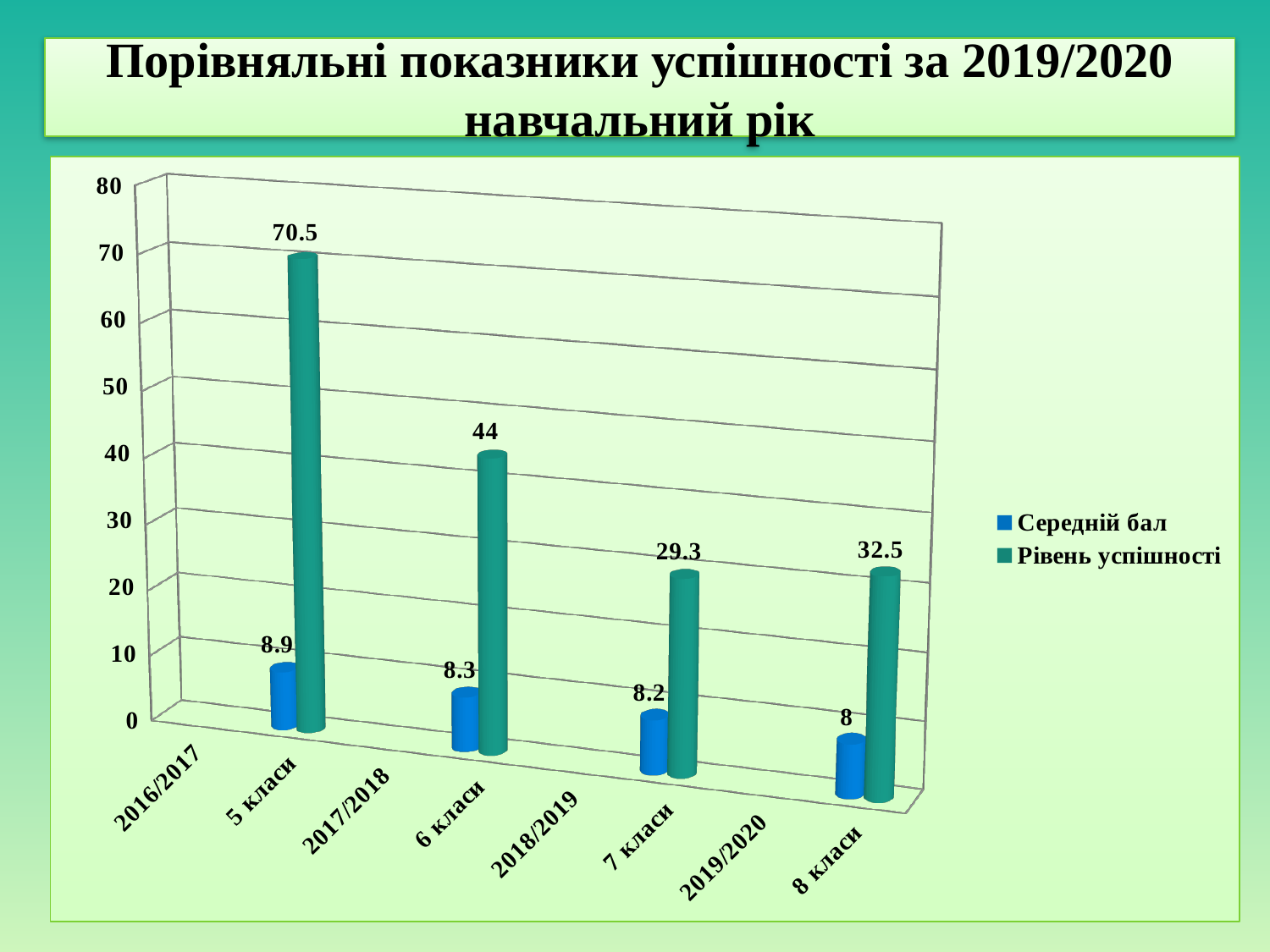
Which category has the highest Рівень успішності? 5 класи How many series does the legend list? 2 Which category has the lowest Середній бал? 8 класи What is the value of Середній бал for 6 класи? 8.3 Which colour represents Середній бал in the legend? Blue What is the value of Рівень успішності for 8 класи? 32.5 Which is larger: Рівень успішності for 7 класи or for 8 класи? 8 класи What is the difference between Рівень успішності for 5 класи and 6 класи? 26.5 What is the value of Середній бал for 7 класи? 8.2 What is the value of Рівень успішності for 5 класи? 70.5 Which category has the lowest Рівень успішності? 7 класи What kind of chart is shown on the slide? Bar chart